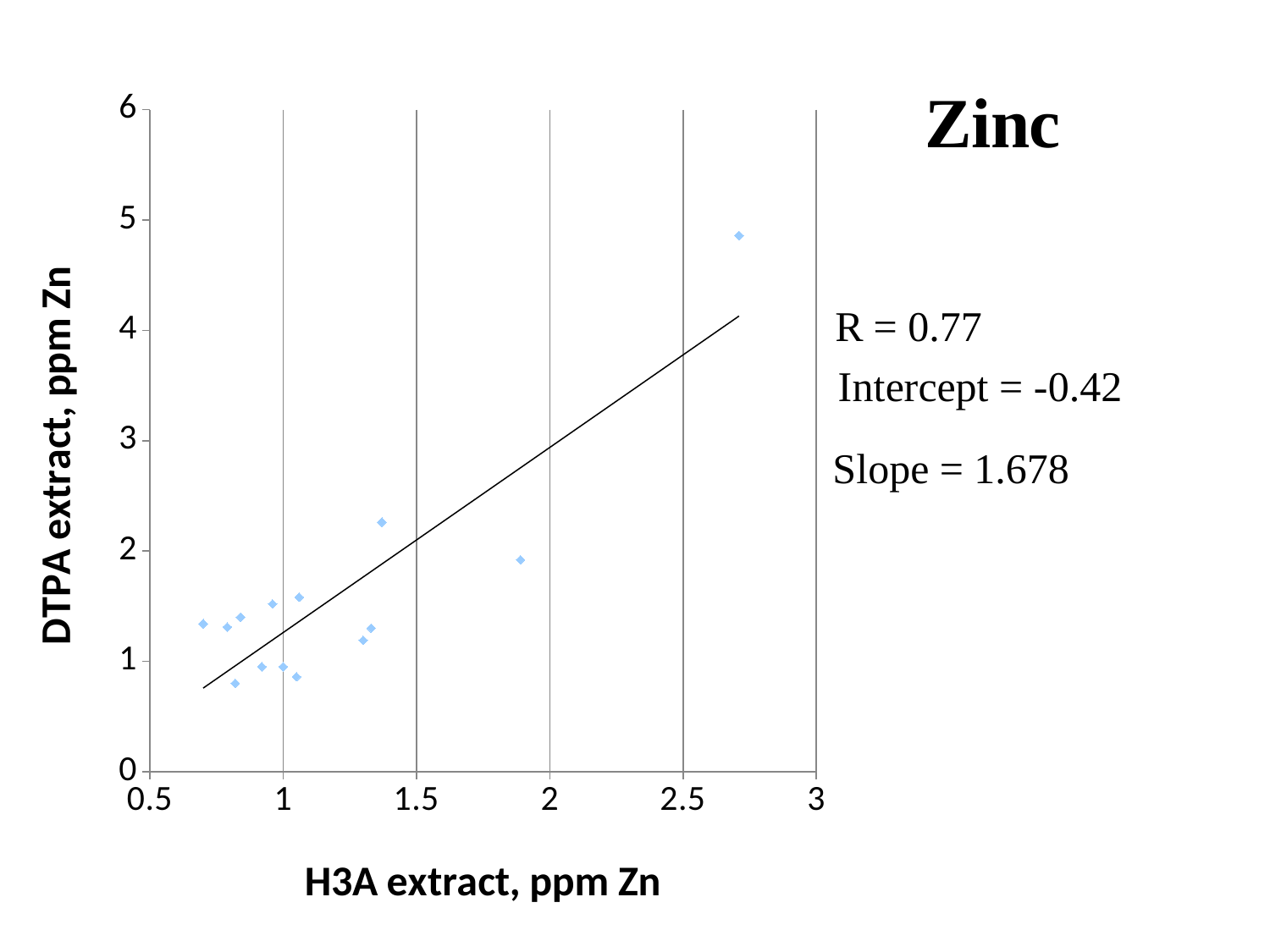
Is the H3A extract value of the point with the highest DTPA value greater or less than 2.5? greater How many points have a DTPA extract value greater than 3? 1 What is the label of the y axis? DTPA extract, ppm Zn What kind of chart is shown on the slide? scatter plot What is the title of the chart? Zinc What intercept is reported for the fitted line? -0.42 What slope is reported for the fitted line? 1.678 Is the highest DTPA extract value plotted greater or less than 4? greater What is the maximum value shown on the y axis? 6 What R value is shown next to the chart? R = 0.77 Do the DTPA extract values generally rise or fall as the H3A extract value increases? rise How many points have an H3A extract value greater than 2? 1